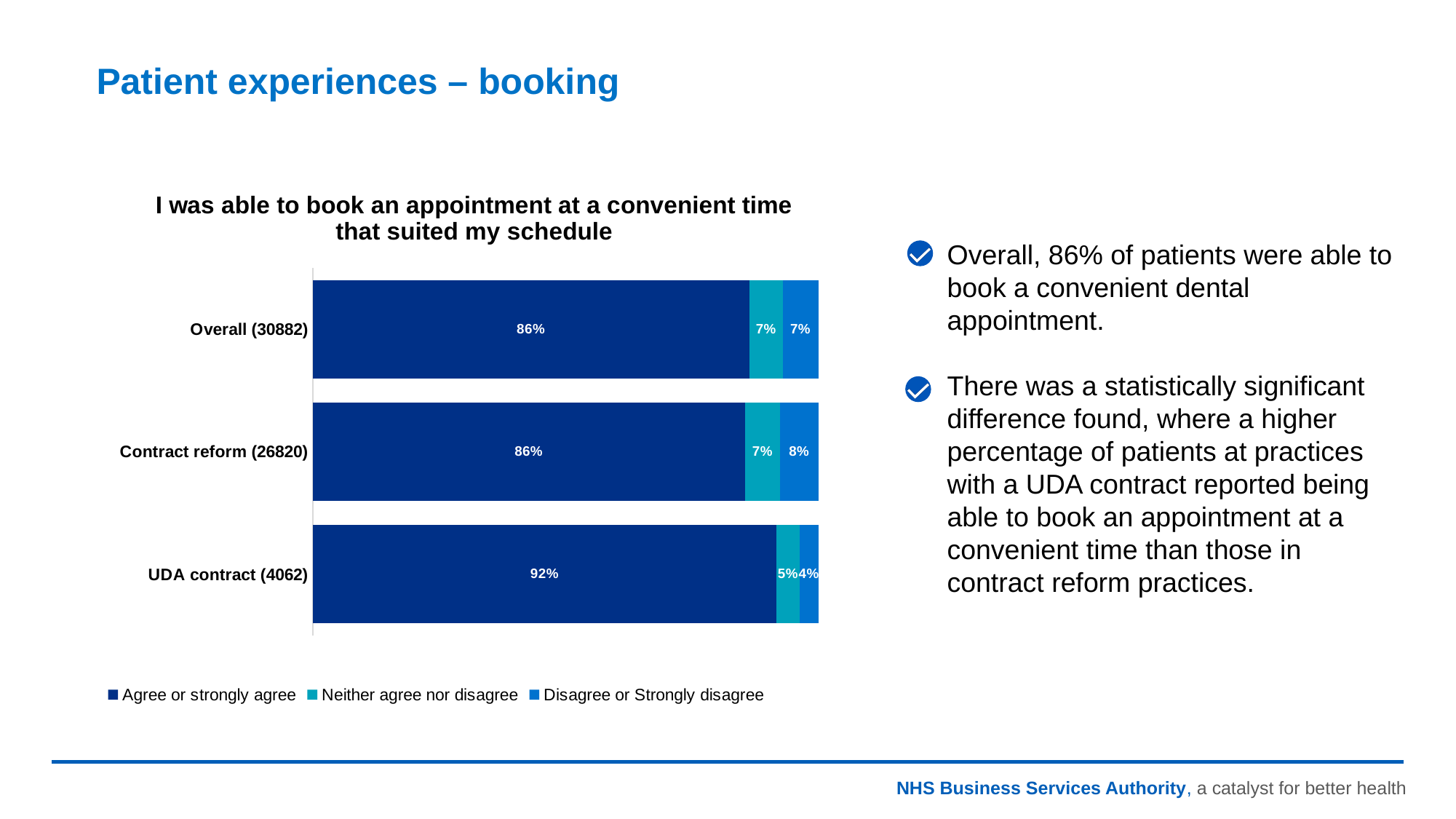
How many series does the legend list? 3 What percentage of UDA contract (4062) respondents agree or strongly agree? 92% What percentage of Contract reform (26820) respondents disagree or strongly disagree? 8% Which category has the lowest percentage of respondents who disagree or strongly disagree? UDA contract (4062) How many categories are shown on the chart? 3 What type of chart is shown on the slide? Stacked bar chart Which category has the highest percentage of respondents who agree or strongly agree? UDA contract (4062) What is the difference in the 'Agree or strongly agree' percentage between UDA contract (4062) and Contract reform (26820)? 6% What percentage of UDA contract (4062) respondents neither agree nor disagree? 5% Which has a larger 'Disagree or Strongly disagree' percentage, Overall (30882) or Contract reform (26820)? Contract reform (26820) What is the title of the chart? I was able to book an appointment at a convenient time that suited my schedule What percentage of Overall (30882) respondents agree or strongly agree that they were able to book an appointment at a convenient time? 86%